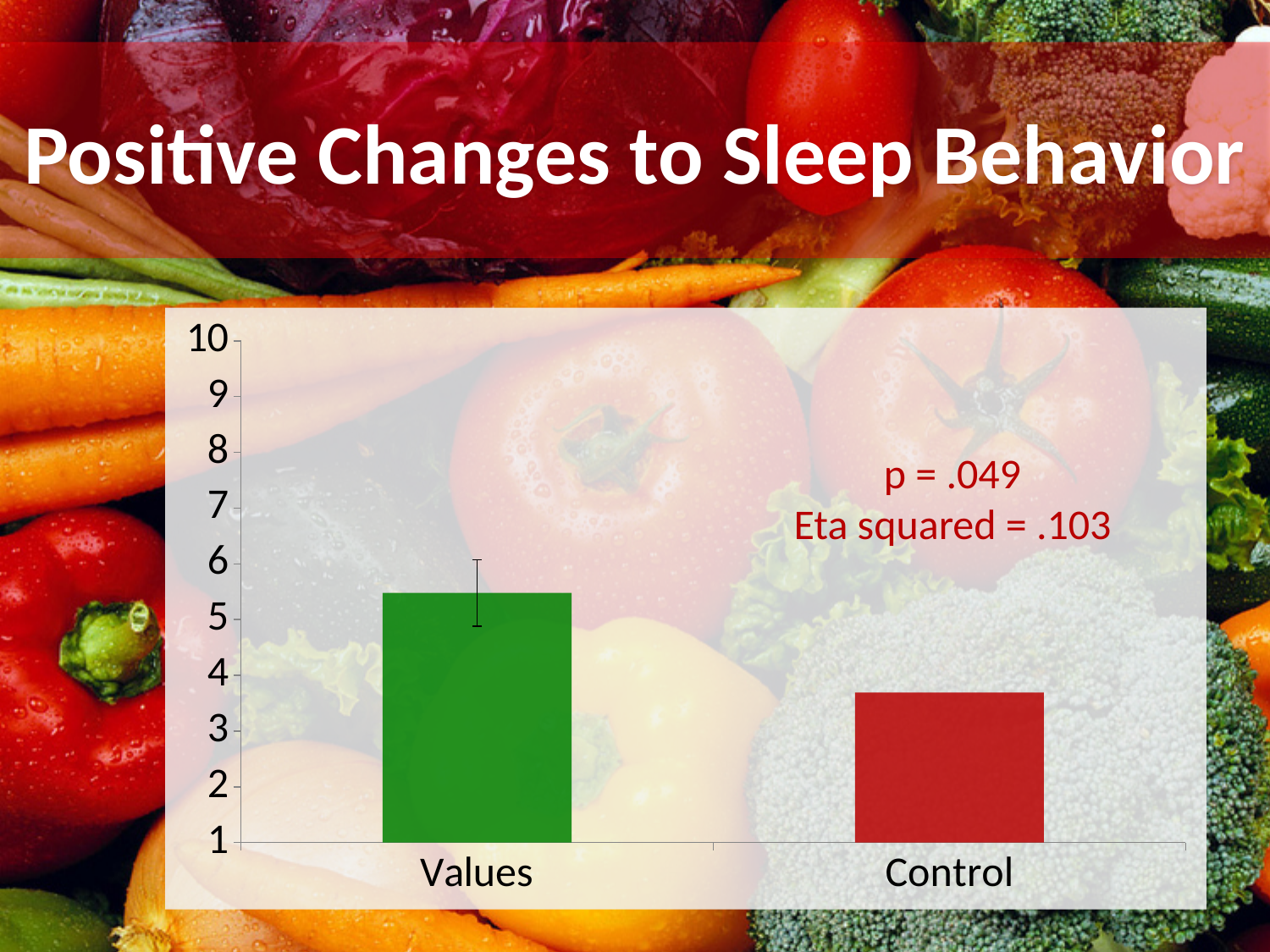
Is the value for Control greater or less than 3? greater What kind of chart is shown on the slide? bar chart Is the value for Control greater or less than 4? less How many categories are plotted in the chart? 2 What is the title of the slide containing the chart? Positive Changes to Sleep Behavior Is the value for Values greater or less than 5? greater What p value is printed on the chart? p = .049 Which is larger, the value for Values or the value for Control? Values Which category has the lowest bar? Control Which category has the highest bar? Values